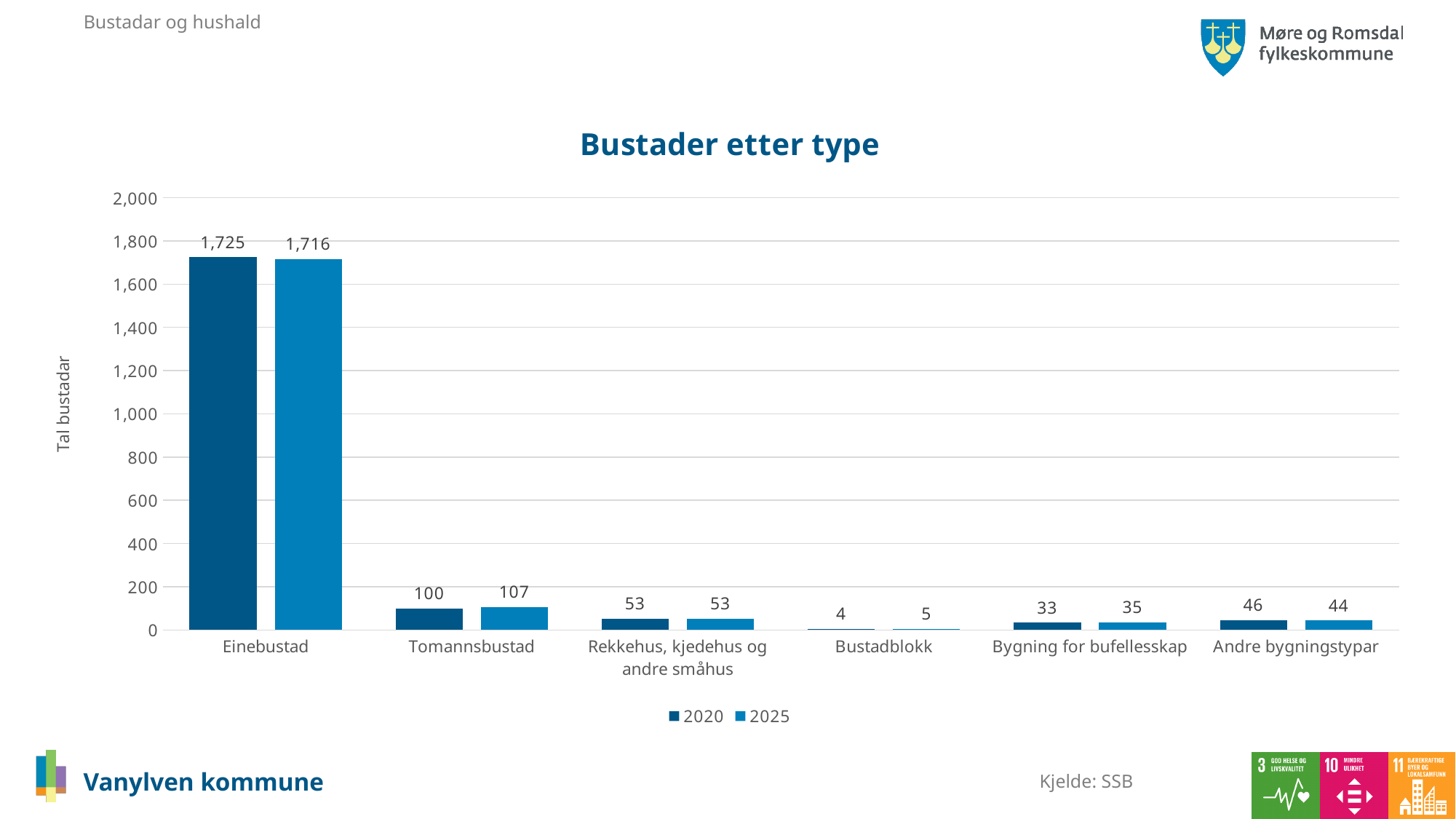
Which category has the lowest value in 2020? Bustadblokk What is the value for Andre bygningstypar in 2025? 44 What is the value for Einebustad in 2020? 1,725 What is the title of the chart? Bustader etter type How many series does the legend list? 2 How many categories are shown on the x axis? 6 Which category has the highest value in 2025? Einebustad What is the value for Bustadblokk in 2020? 4 What is the difference between the 2020 and 2025 values for Einebustad? 9 Which is larger for Bygning for bufellesskap: the 2020 value or the 2025 value? 2025 What is the value for Tomannsbustad in 2025? 107 What kind of chart is shown? Bar chart